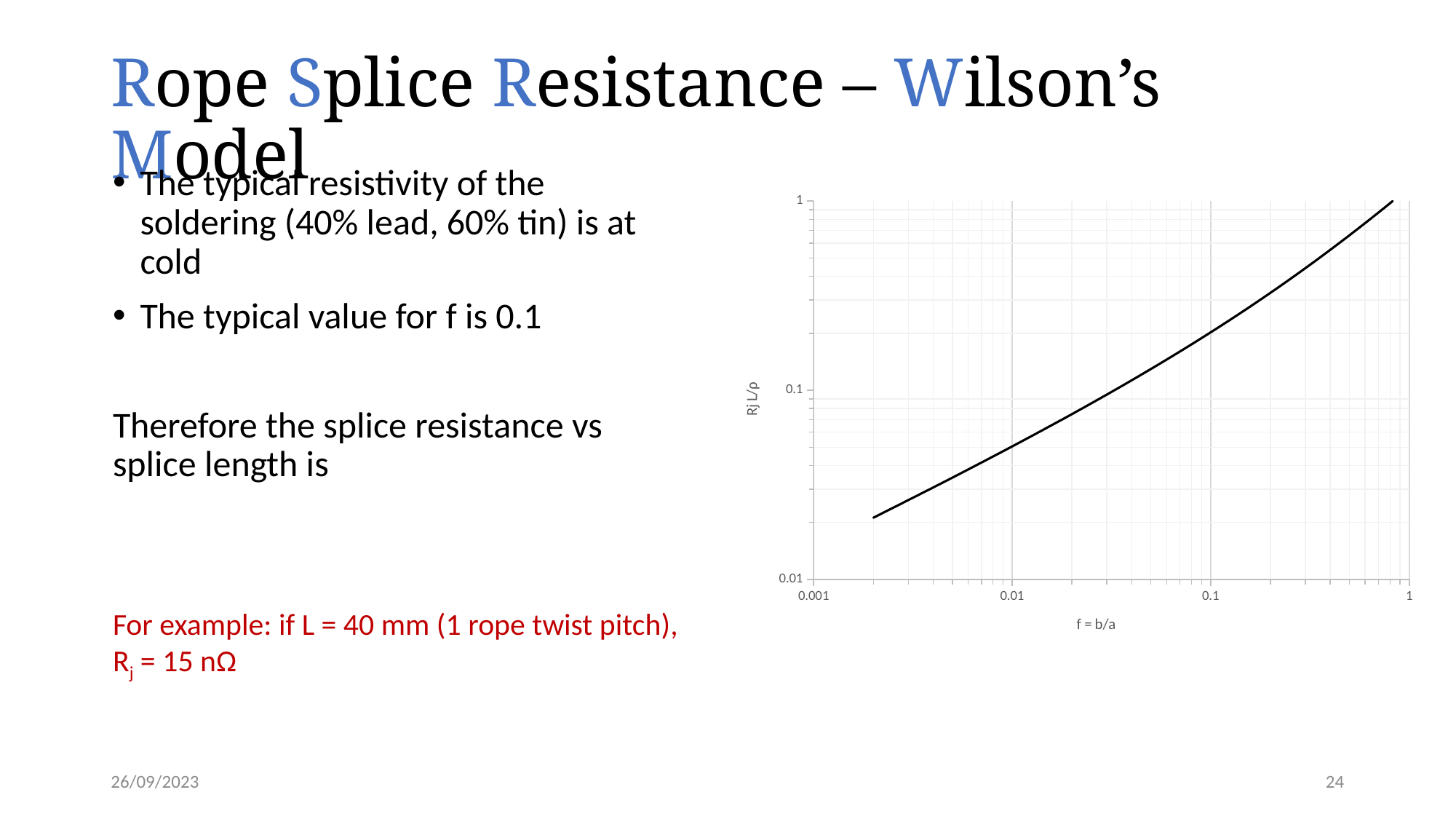
How many lines are plotted on the chart? 1 What is the label of the x axis of the chart? f = b/a Does the value of Rj L/ρ rise or fall as f = b/a increases along the x axis? rise Is the value of Rj L/ρ at f = b/a = 0.002 greater or less than 0.1? less What is the label of the y axis of the chart? Rj L/ρ Is the value of Rj L/ρ at f = b/a = 0.1 greater or less than 1? less What kind of chart is shown on the slide? line chart Is the value of Rj L/ρ at f = b/a = 0.01 greater or less than 0.01? greater Which is larger, the value of Rj L/ρ at f = b/a = 0.01 or at f = b/a = 0.1? at f = b/a = 0.1 What is the highest tick value shown on the x axis of the chart? 1